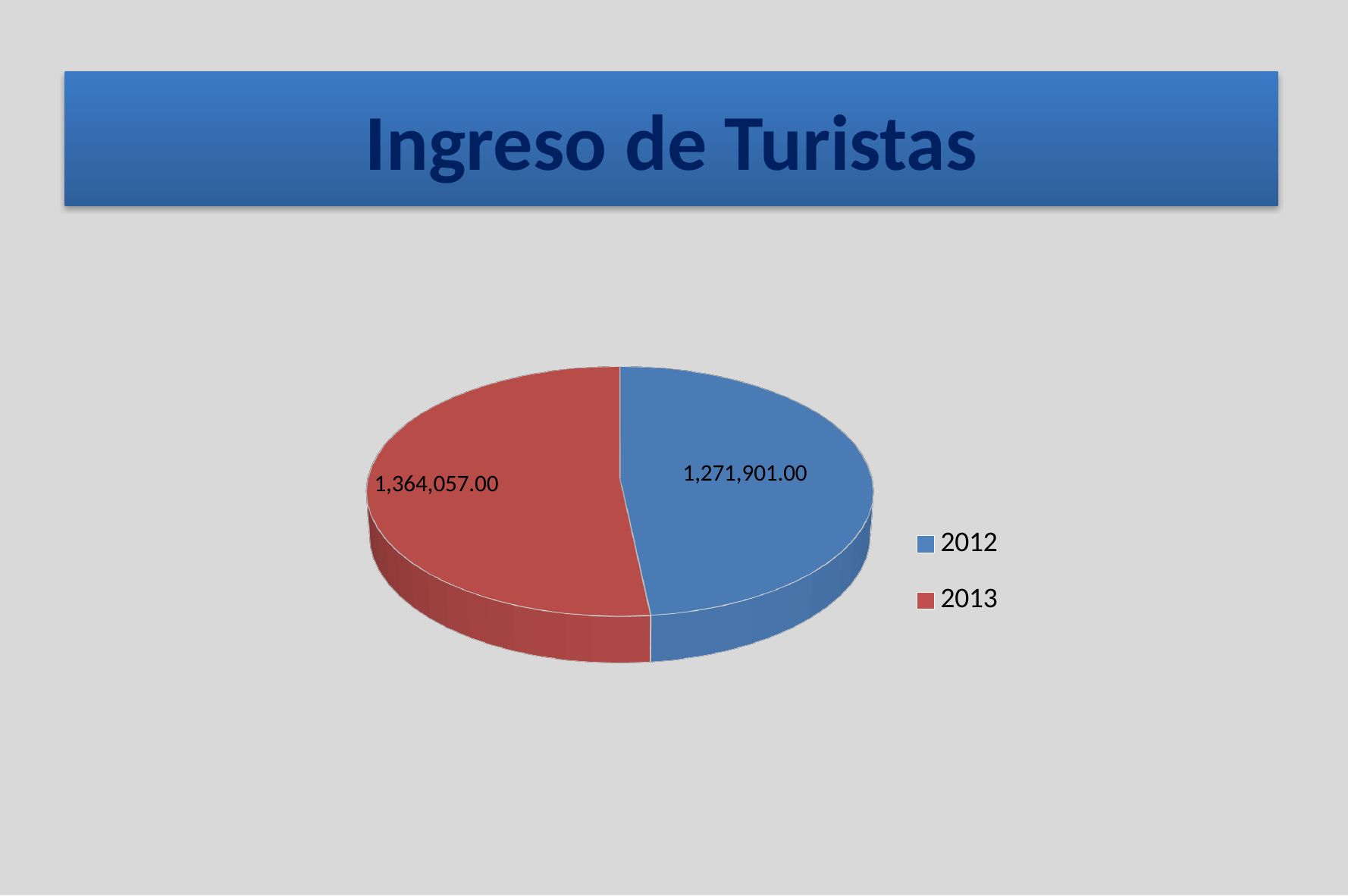
How many entries does the legend list? 2 Which year has the larger slice in the pie chart? 2013 Which year has the smaller slice in the pie chart? 2012 What value is shown for 2013 in the pie chart? 1,364,057.00 What is the difference between the 2013 value and the 2012 value? 92,156.00 To the nearest whole percent, what share of the pie does 2013 represent? 52% What is the total of the two values shown in the pie chart? 2,635,958.00 Is the value for 2012 larger or smaller than the value for 2013? smaller What is the title of the slide containing the pie chart? Ingreso de Turistas What kind of chart is shown on the slide? pie chart What value is shown for 2012 in the pie chart? 1,271,901.00 How many slices does the pie chart have? 2